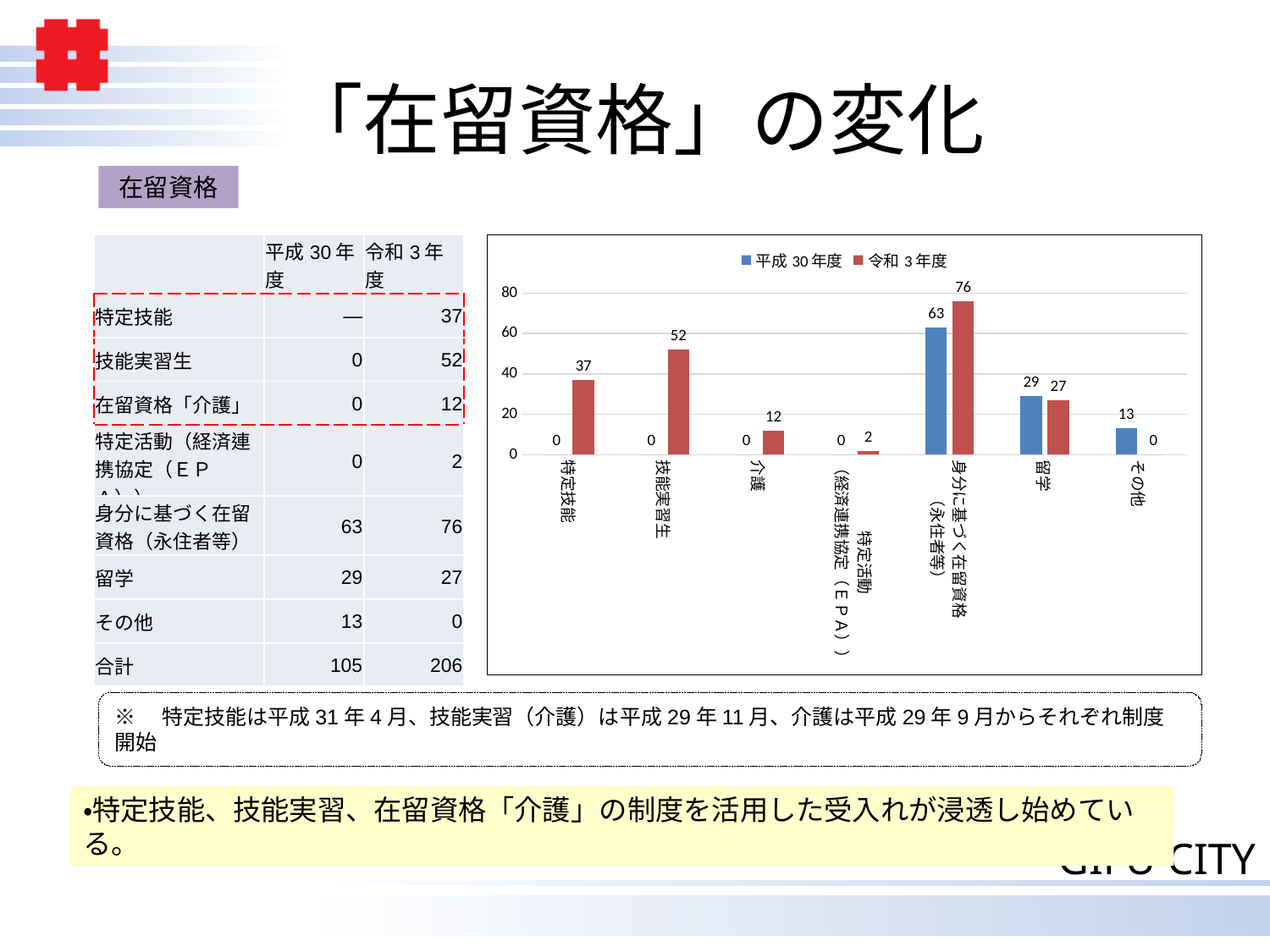
What is the 平成30年度 value for 身分に基づく在留資格（永住者等） in the chart? 63 For 留学, which is larger: the 平成30年度 value or the 令和3年度 value? 平成30年度 What is the 令和3年度 value for その他 in the chart? 0 What type of chart is shown on the slide? bar chart What is the 令和3年度 value for 介護 in the chart? 12 What is the 令和3年度 value for 技能実習生 in the chart? 52 Which colour represents the 令和3年度 series in the chart? red How many categories are shown on the x axis of the chart? 7 How many series does the chart legend list? 2 Which category has the highest 平成30年度 value in the chart? 身分に基づく在留資格（永住者等） What is the difference between the 令和3年度 and 平成30年度 values for 身分に基づく在留資格（永住者等）? 13 Which category has the highest 令和3年度 value in the chart? 身分に基づく在留資格（永住者等）